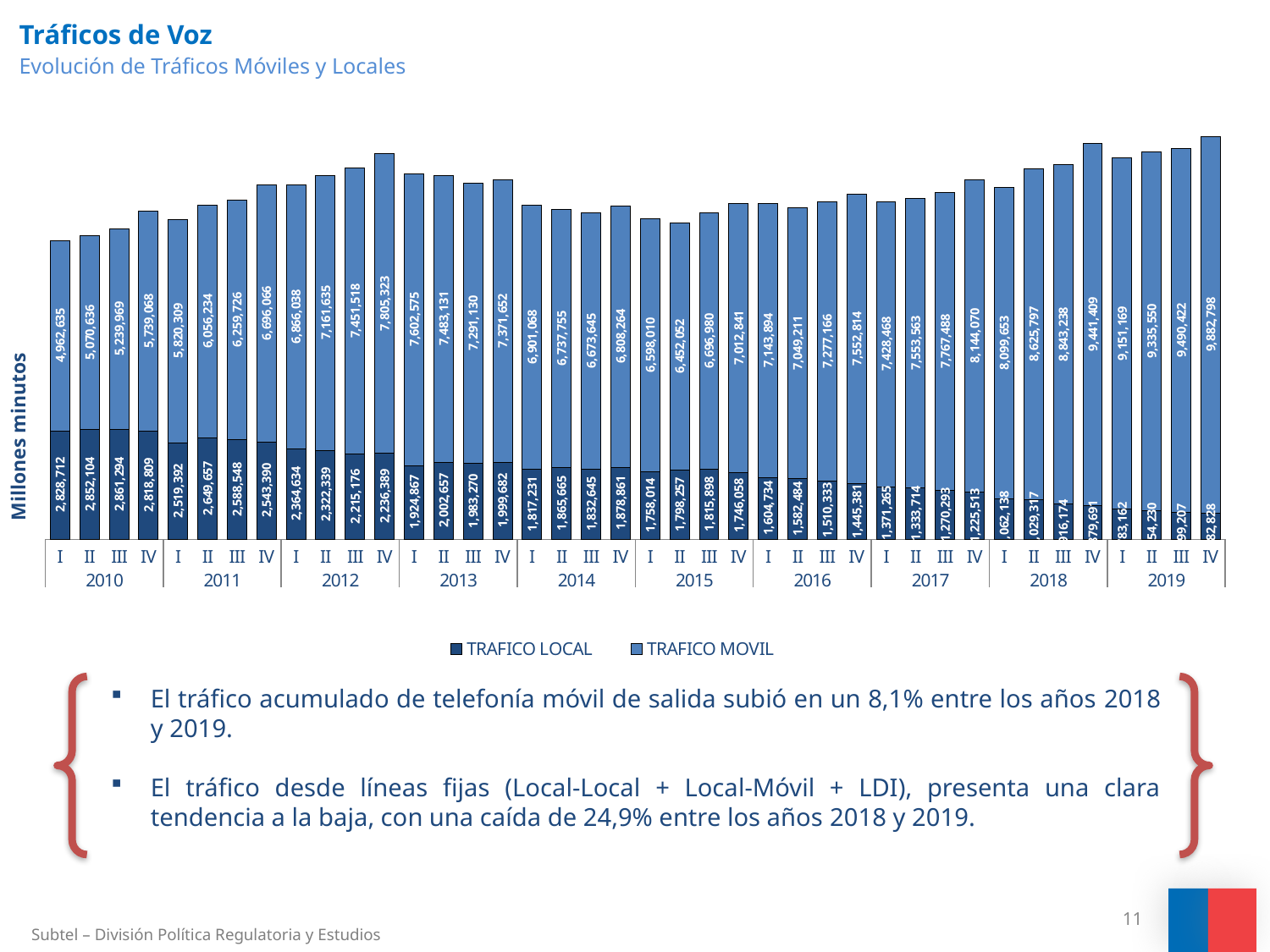
What is the total of the stacked bar for quarter I of 2010 (TRAFICO LOCAL plus TRAFICO MOVIL)? 7,791,347 In which quarter is TRAFICO MOVIL highest? IV 2019 What kind of chart is shown on the slide? Stacked bar chart What is the TRAFICO LOCAL value for quarter I of 2010? 2,828,712 What is the difference between the TRAFICO MOVIL values for quarter IV of 2019 and quarter I of 2019? 731,629 What is the label on the vertical axis of the chart? Millones minutos What is the TRAFICO MOVIL value for quarter IV of 2019? 9,882,798 In which quarter is TRAFICO MOVIL lowest? I 2010 Does the TRAFICO LOCAL series generally rise or fall from 2010 to 2019? Fall Which is larger, the TRAFICO MOVIL value for quarter IV of 2012 or for quarter IV of 2013? IV 2012 What is the TRAFICO MOVIL value for quarter IV of 2012? 7,805,323 How many series does the legend list? 2